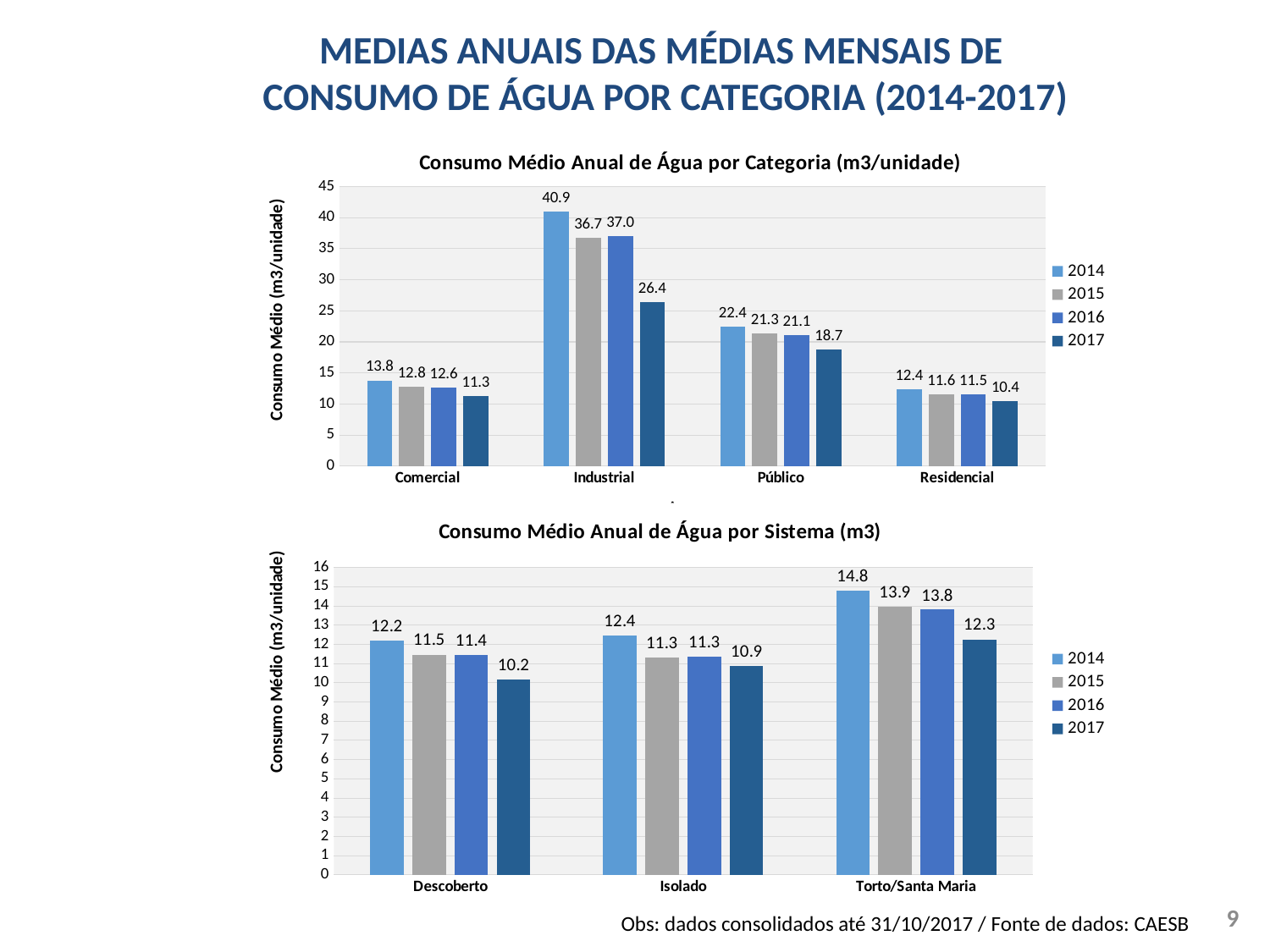
In the chart 'Consumo Médio Anual de Água por Categoria (m3/unidade)', how many categories are shown on the x axis? 4 What kind of chart is 'Consumo Médio Anual de Água por Sistema (m3)'? bar chart In the chart 'Consumo Médio Anual de Água por Sistema (m3)', which is larger: Descoberto in 2014 or Isolado in 2014? Isolado in 2014 In the chart 'Consumo Médio Anual de Água por Sistema (m3)', how many series does the legend list? 4 In the chart 'Consumo Médio Anual de Água por Sistema (m3)', what is the value for Torto/Santa Maria in 2014? 14.8 In the chart 'Consumo Médio Anual de Água por Sistema (m3)', which system has the lowest value in 2017? Descoberto In the chart 'Consumo Médio Anual de Água por Categoria (m3/unidade)', which category has the lowest value in 2017? Residencial In the chart 'Consumo Médio Anual de Água por Categoria (m3/unidade)', which category has the highest value in 2016? Industrial In the chart 'Consumo Médio Anual de Água por Categoria (m3/unidade)', do the Comercial values rise or fall from 2014 to 2017? fall In the chart 'Consumo Médio Anual de Água por Categoria (m3/unidade)', what is the value for Público in 2017? 18.7 In the chart 'Consumo Médio Anual de Água por Categoria (m3/unidade)', what is the value for Industrial in 2014? 40.9 In the chart 'Consumo Médio Anual de Água por Categoria (m3/unidade)', what is the difference between the Industrial values for 2016 and 2017? 10.6